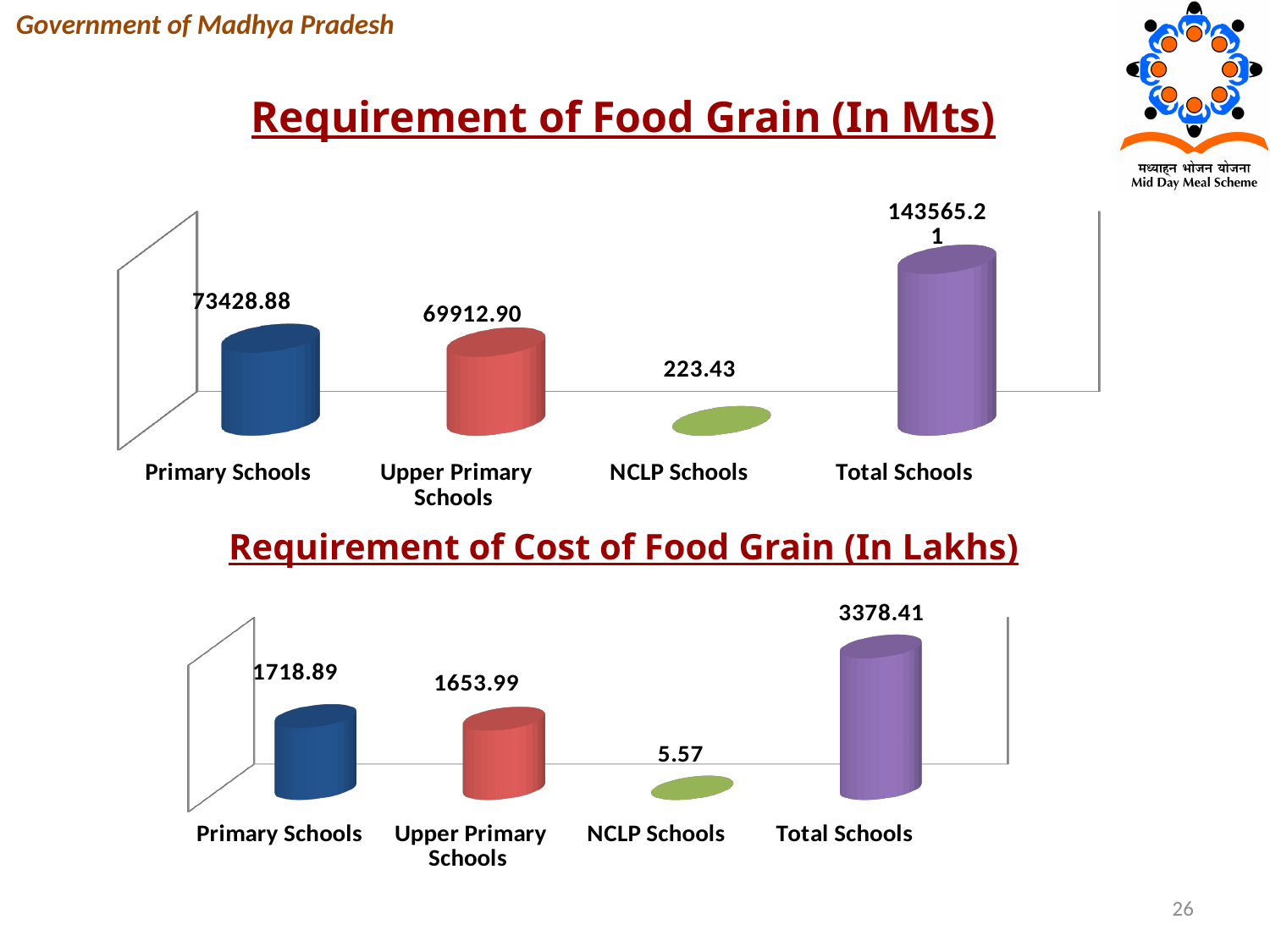
In the 'Requirement of Cost of Food Grain (In Lakhs)' chart, what is the difference between the values for Total Schools and Primary Schools? 1659.52 In the 'Requirement of Cost of Food Grain (In Lakhs)' chart, which is larger, the value for Primary Schools or Upper Primary Schools? Primary Schools In the 'Requirement of Cost of Food Grain (In Lakhs)' chart, what is the value for Upper Primary Schools? 1653.99 In the 'Requirement of Cost of Food Grain (In Lakhs)' chart, what is the value for Total Schools? 3378.41 In the 'Requirement of Food Grain (In Mts)' chart, what is the difference between the values for Primary Schools and Upper Primary Schools? 3515.98 In the 'Requirement of Food Grain (In Mts)' chart, what is the value for Primary Schools? 73428.88 What type of chart is the 'Requirement of Cost of Food Grain (In Lakhs)' chart? Bar chart In the 'Requirement of Food Grain (In Mts)' chart, what is the value for NCLP Schools? 223.43 In the 'Requirement of Food Grain (In Mts)' chart, which category has the highest value? Total Schools In the 'Requirement of Food Grain (In Mts)' chart, which category has the lowest value? NCLP Schools In the 'Requirement of Food Grain (In Mts)' chart, how many categories are shown? 4 In the 'Requirement of Cost of Food Grain (In Lakhs)' chart, which category has the lowest value? NCLP Schools